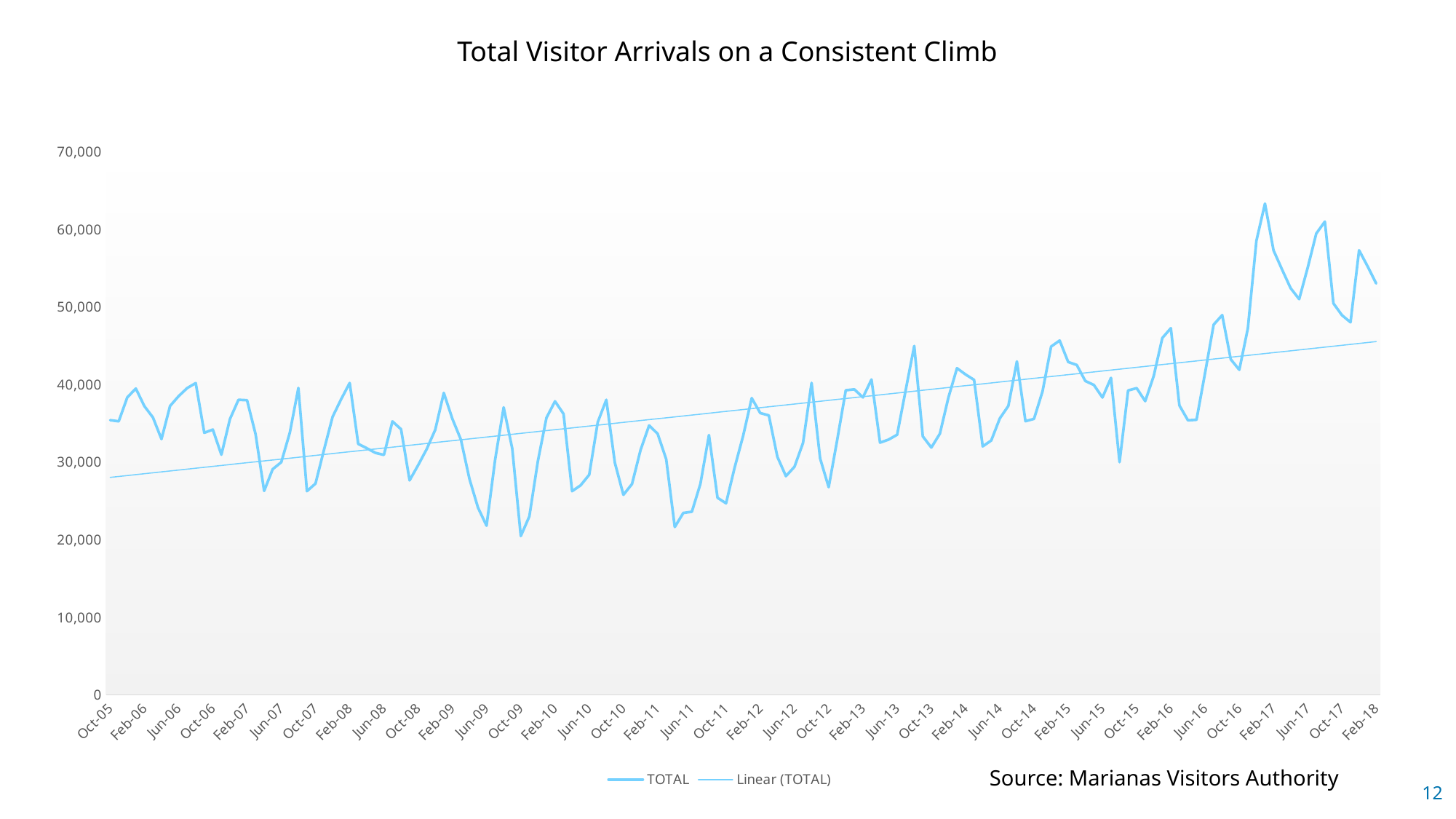
What are the two entries in the chart legend? TOTAL and Linear (TOTAL) Is the TOTAL value at Feb-18 greater or less than 50,000? greater Does the linear trendline rise or fall from Oct-05 to Feb-18? Rises Is the TOTAL value at Oct-05 greater or less than 30,000? greater Which is larger, the TOTAL value at Feb-18 or at Oct-05? Feb-18 What kind of chart is shown on the slide? Line chart Is the TOTAL value at Feb-17 greater or less than 60,000? less What is the title of the chart? Total Visitor Arrivals on a Consistent Climb How many series does the legend list? 2 Around which x-axis label does the TOTAL line reach its highest peak? Feb-17 How many labels are shown on the x axis? 38